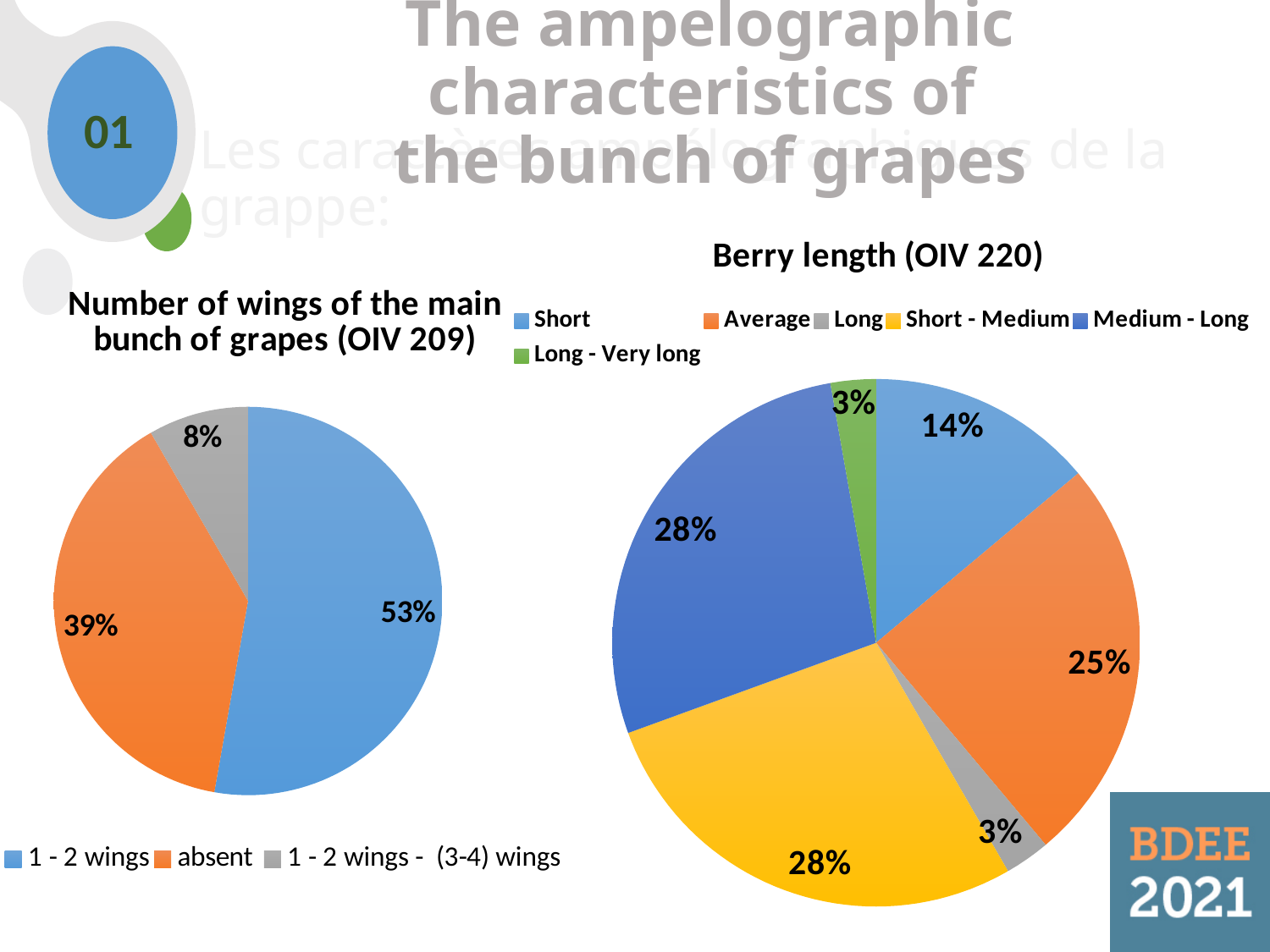
In the 'Number of wings of the main bunch of grapes (OIV 209)' chart, which category has the largest slice? 1 - 2 wings What type of chart is the 'Berry length (OIV 220)' chart? Pie chart In the 'Number of wings of the main bunch of grapes (OIV 209)' chart, what is the difference in percentage points between '1 - 2 wings' and 'absent'? 14 In the 'Number of wings of the main bunch of grapes (OIV 209)' chart, what share is labelled for 'absent'? 39% In the 'Berry length (OIV 220)' chart, what share is labelled for 'Short - Medium'? 28% How many categories does the legend of the 'Number of wings of the main bunch of grapes (OIV 209)' chart list? 3 How many categories does the legend of the 'Berry length (OIV 220)' chart list? 6 In the 'Number of wings of the main bunch of grapes (OIV 209)' chart, what share is labelled for '1 - 2 wings'? 53% In the 'Number of wings of the main bunch of grapes (OIV 209)' chart, which category has the smallest slice? 1 - 2 wings - (3-4) wings In the 'Berry length (OIV 220)' chart, which is larger, the 'Average' slice or the 'Short' slice? Average